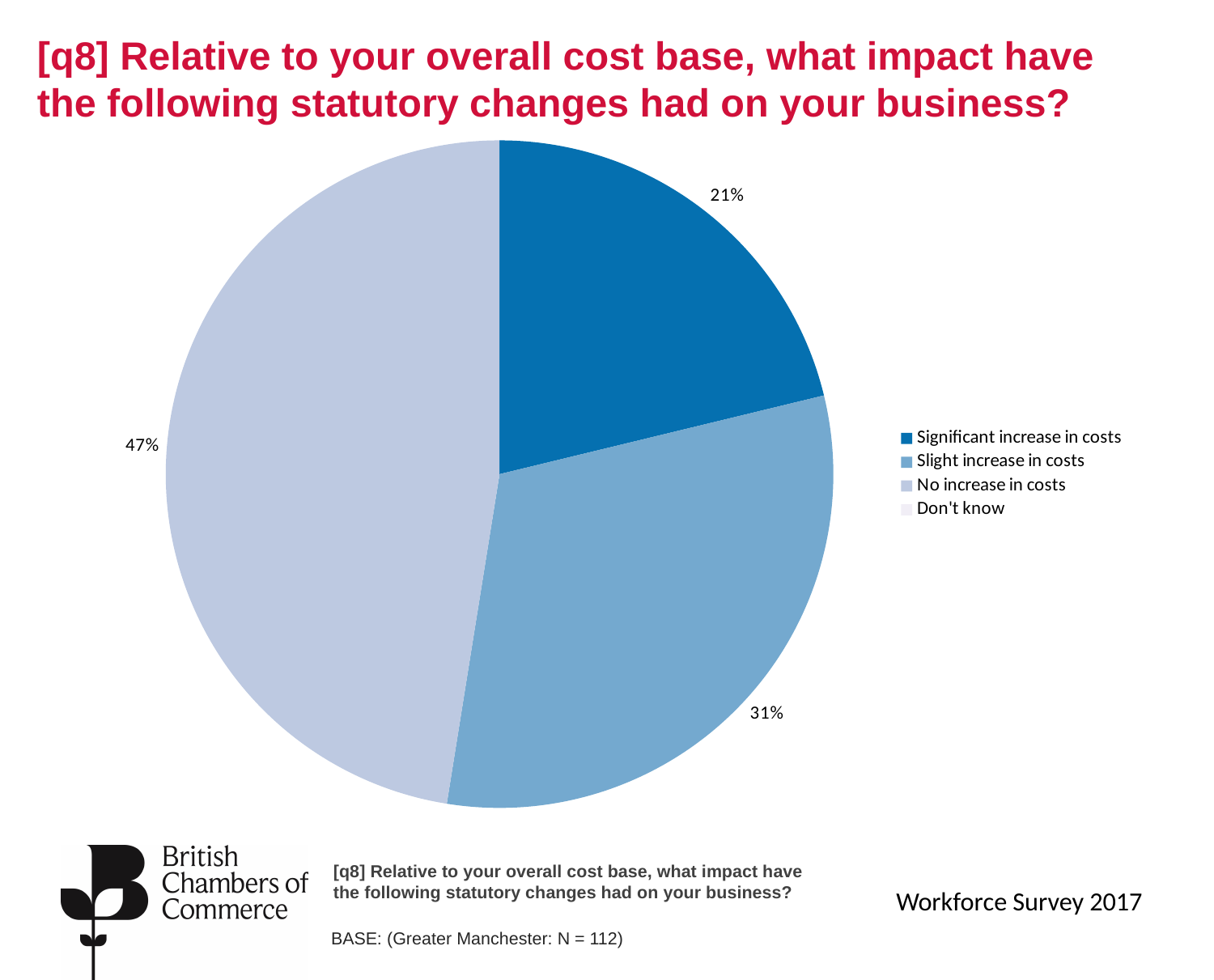
What percentage of respondents reported no increase in costs? 47% Of the labelled slices, which response category has the smallest share? Significant increase in costs What percentage of respondents reported a slight increase in costs? 31% What is the difference in percentage points between 'No increase in costs' and 'Significant increase in costs'? 26 Which is larger: the share for 'Slight increase in costs' or 'Significant increase in costs'? Slight increase in costs What percentage of respondents reported a significant increase in costs? 21% Which survey is named in the bottom right of the slide? Workforce Survey 2017 How many entries does the legend list? 4 Which response category has the largest share of the pie? No increase in costs What is the difference in percentage points between 'Slight increase in costs' and 'Significant increase in costs'? 10 What is the sample size (N) stated in the base note on the slide? 112 What type of chart is shown on the slide? Pie chart